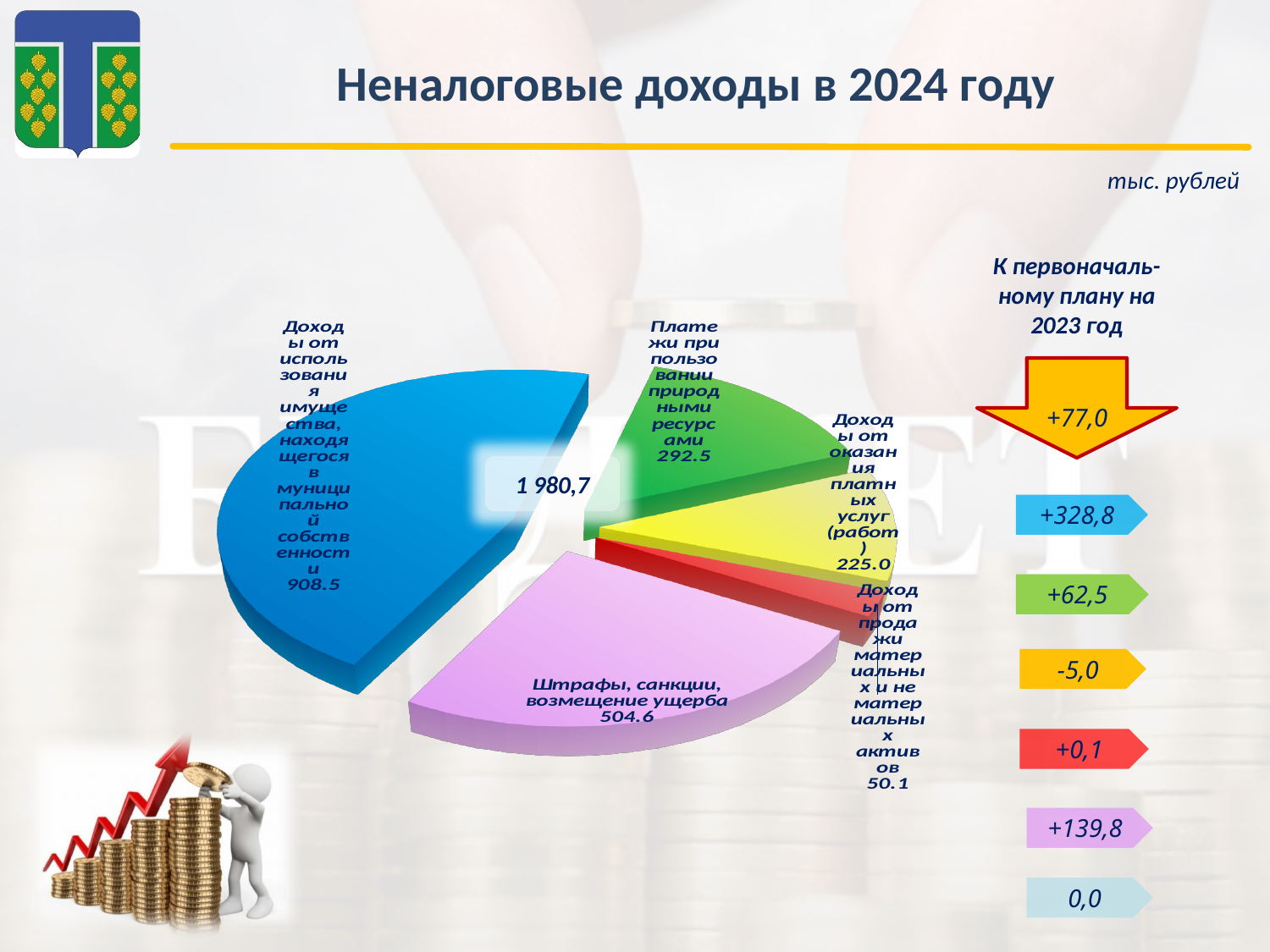
What is the value for «Штрафы, санкции, возмещение ущерба»? 504.6 What total value is shown in the centre of the pie chart? 1 980,7 Which category has the smallest value in the pie chart? Доходы от продажи материальных и нематериальных активов How many slices does the pie chart have? 5 What is the value for «Доходы от продажи материальных и нематериальных активов»? 50.1 What is the value for «Платежи при пользовании природными ресурсами»? 292.5 Which category has the largest value in the pie chart? Доходы от использования имущества, находящегося в муниципальной собственности What type of chart is shown on the slide? pie chart What is the difference between «Доходы от использования имущества, находящегося в муниципальной собственности» (908.5) and «Штрафы, санкции, возмещение ущерба» (504.6)? 403.9 What is the title of the slide containing the pie chart? Неналоговые доходы в 2024 году What is the value for «Доходы от оказания платных услуг (работ)»? 225.0 Which is larger: «Платежи при пользовании природными ресурсами» or «Доходы от оказания платных услуг (работ)»? Платежи при пользовании природными ресурсами